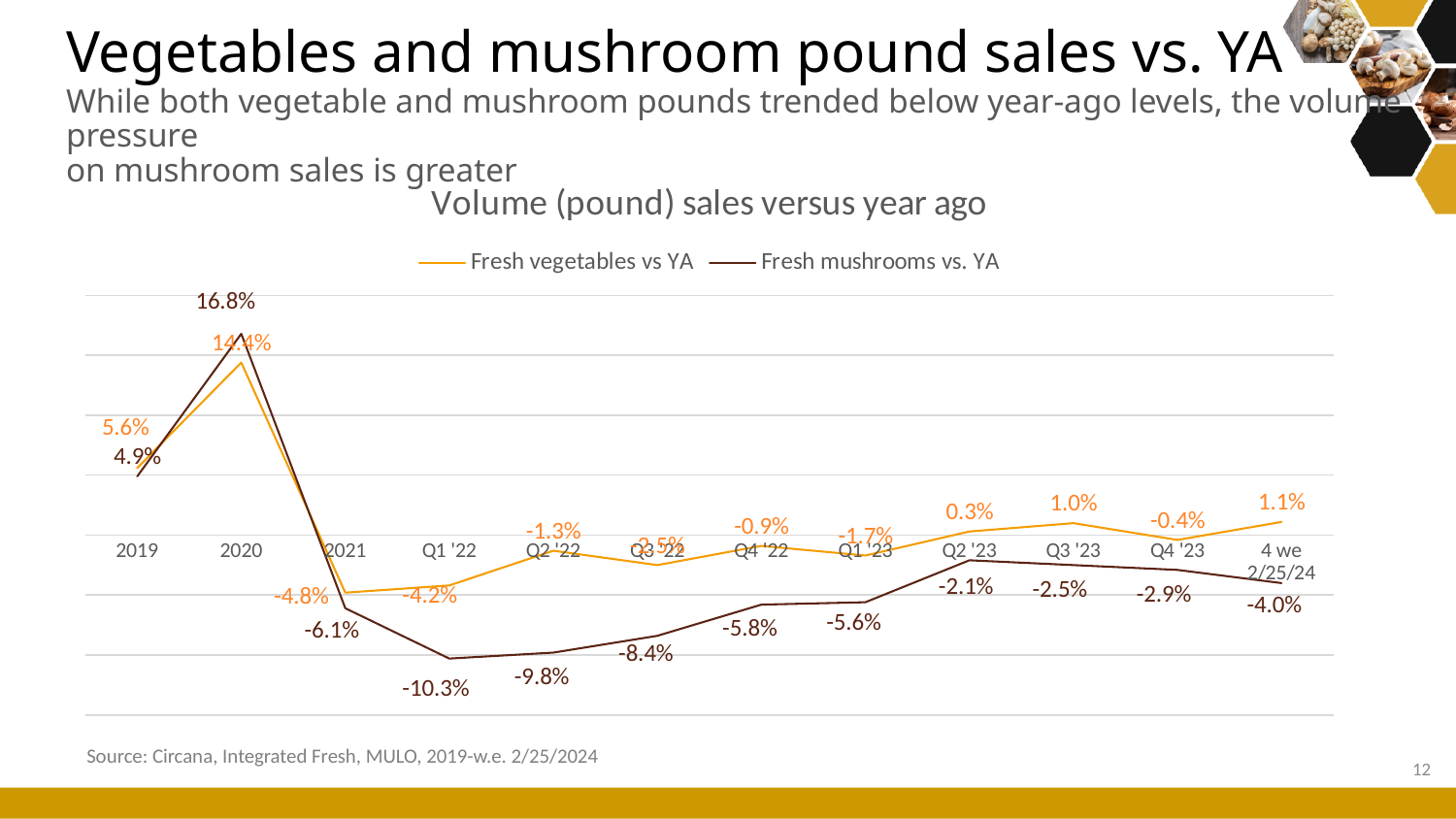
What is the value for Fresh vegetables vs YA in 2020? 14.4% What is the value for Fresh mushrooms vs. YA in Q1 '22? -10.3% In which period is the Fresh vegetables vs YA value highest? 2020 What kind of chart is shown on the slide? line chart How many time periods are plotted along the x axis? 12 Does the Fresh mushrooms vs. YA line rise or fall from Q1 '22 to Q2 '23? rise What is the value for Fresh mushrooms vs. YA in 2020? 16.8% How many series does the legend list? 2 In which period is the Fresh mushrooms vs. YA value lowest? Q1 '22 What is the value for Fresh vegetables vs YA in the 4 we 2/25/24 period? 1.1% In Q4 '23, which series has the larger value, Fresh vegetables vs YA or Fresh mushrooms vs. YA? Fresh vegetables vs YA In 2020, how much higher is the Fresh mushrooms vs. YA value than the Fresh vegetables vs YA value? 2.4 percentage points